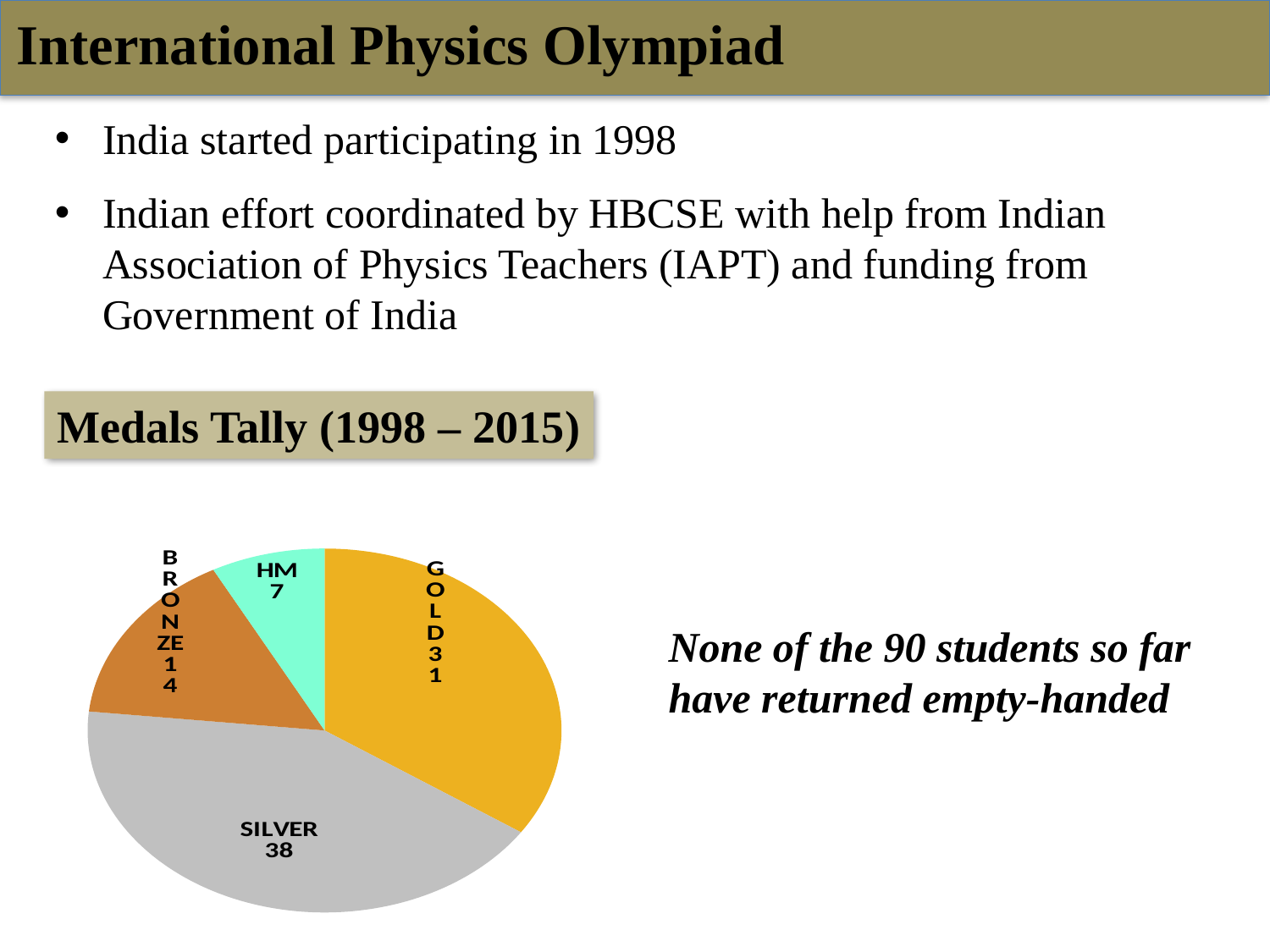
What is the difference between the SILVER and GOLD values in the pie chart? 7 How many medals does the GOLD slice of the pie chart represent? 31 What value is shown for the BRONZE slice of the pie chart? 14 What is the total of all the values shown in the pie chart? 90 What is the difference between the BRONZE and HM values in the pie chart? 7 Which is larger in the pie chart, GOLD or BRONZE? GOLD What type of chart is shown on the slide? pie chart Which slice of the pie chart has the largest value? SILVER What value is shown for the HM slice of the pie chart? 7 Which slice of the pie chart has the smallest value? HM What value is shown for the SILVER slice of the pie chart? 38 How many slices does the pie chart have? 4